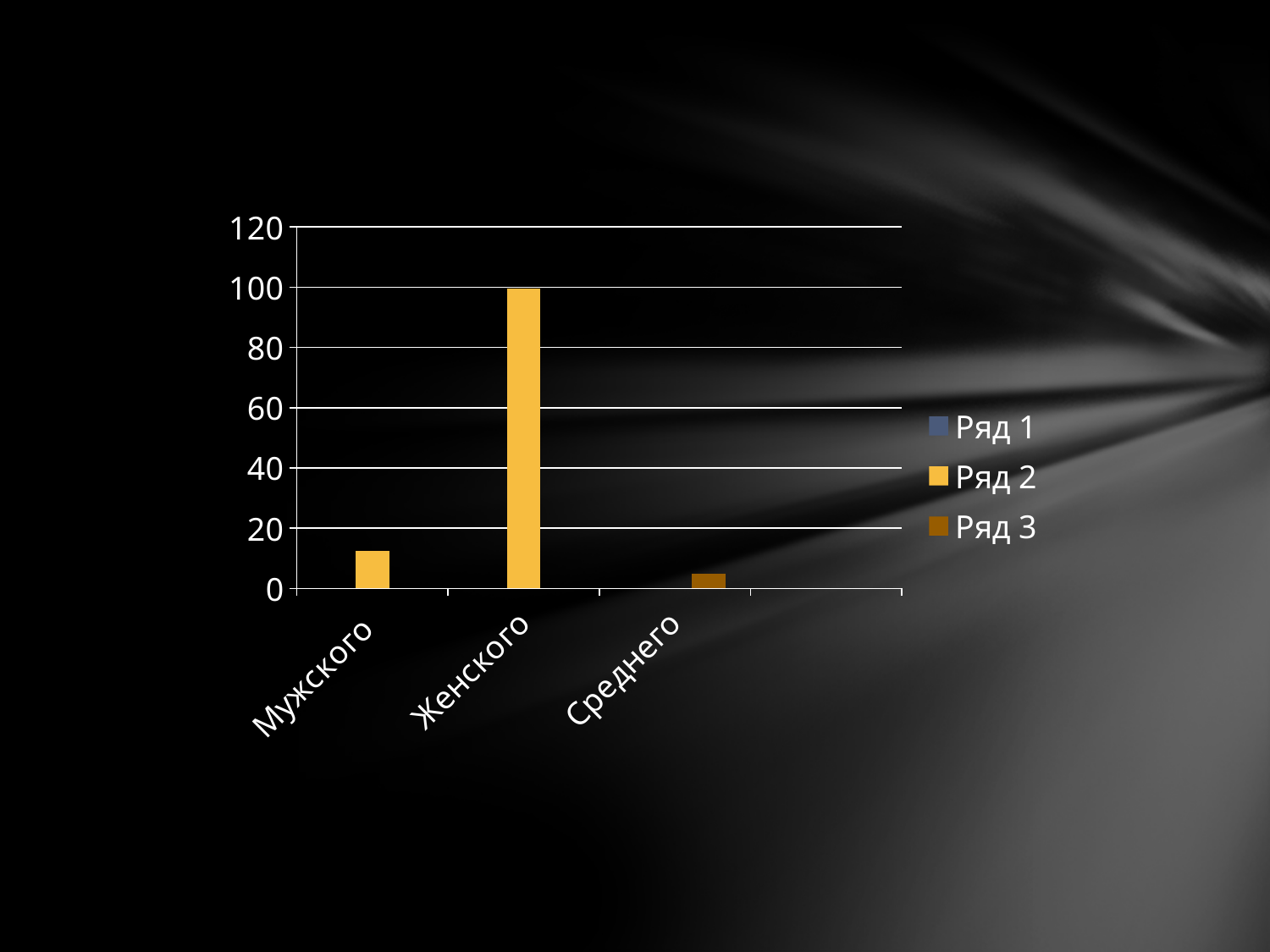
What are the series names listed in the chart legend? Ряд 1, Ряд 2, Ряд 3 Which has the larger value, Женского or Мужского? Женского Is the value for Среднего greater or less than 20? less How many series does the legend of the chart list? 3 Which series does the bar for Среднего belong to, according to the legend colours? Ряд 3 Which category has the lowest bar in the chart? Среднего How many categories are shown on the x axis of the chart? 3 What kind of chart is shown on the slide? bar chart Which has the larger value, Мужского or Среднего? Мужского Is the value for Мужского greater or less than 20? less Is the value for Женского greater or less than 80? greater Which category has the highest bar in the chart? Женского